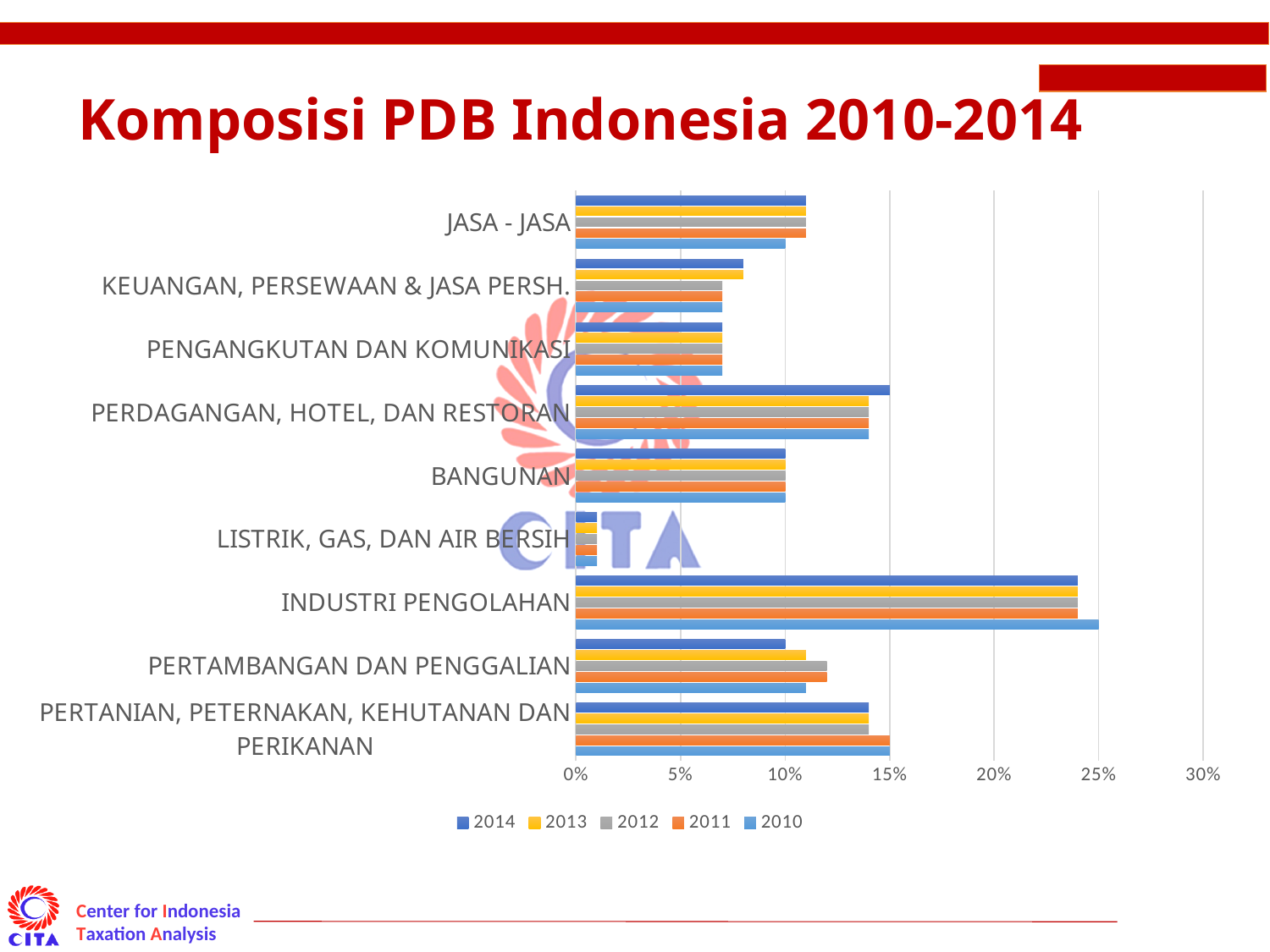
How many series does the legend list? 5 Is the 2014 value for LISTRIK, GAS, DAN AIR BERSIH greater or less than 5%? less Is the 2014 value for INDUSTRI PENGOLAHAN greater or less than 20%? greater Is the 2014 value for KEUANGAN, PERSEWAAN & JASA PERSH. greater or less than 10%? less What kind of chart is shown on the slide? bar chart What is the title of the slide's chart? Komposisi PDB Indonesia 2010-2014 Which category has the lowest value for 2014? LISTRIK, GAS, DAN AIR BERSIH Which category has the highest value for 2014? INDUSTRI PENGOLAHAN For 2014, which is larger: INDUSTRI PENGOLAHAN or PERTANIAN, PETERNAKAN, KEHUTANAN DAN PERIKANAN? INDUSTRI PENGOLAHAN For 2014, which is larger: BANGUNAN or LISTRIK, GAS, DAN AIR BERSIH? BANGUNAN How many categories are plotted on the chart? 9